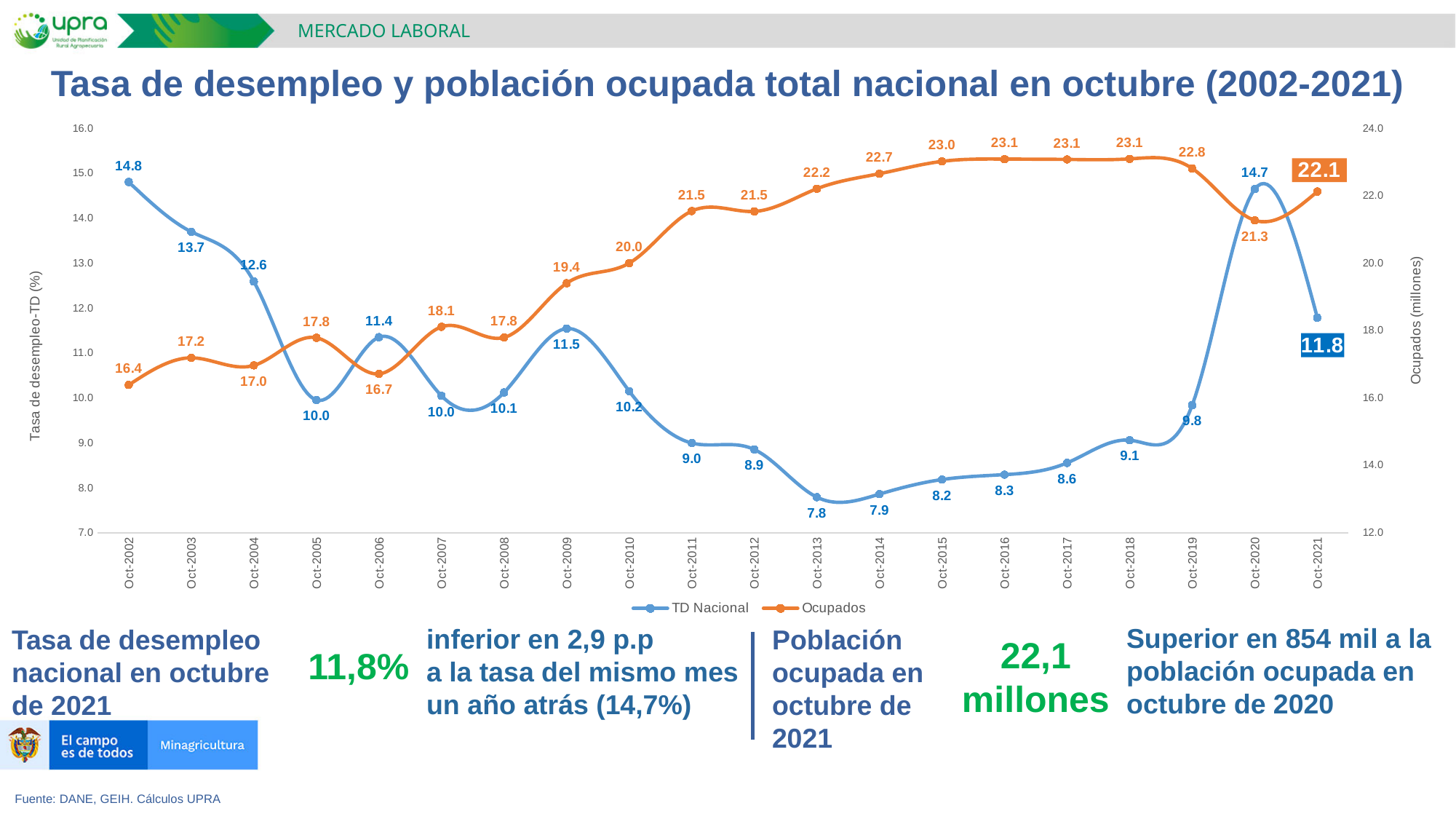
What is the Ocupados value for Oct-2010? 20.0 How many data points does each series have? 20 What is the difference between the TD Nacional values for Oct-2020 and Oct-2021? 2.9 In which year is the TD Nacional value highest? Oct-2002 In which year is the Ocupados value lowest? Oct-2002 What is the Ocupados value for Oct-2021? 22.1 In which year is the TD Nacional value lowest? Oct-2013 What is the TD Nacional value for Oct-2013? 7.8 What kind of chart is shown on the slide? Line chart What is the TD Nacional value for Oct-2021? 11.8 How many series does the legend list? 2 Which is larger, the Ocupados value for Oct-2019 or for Oct-2020? Oct-2019